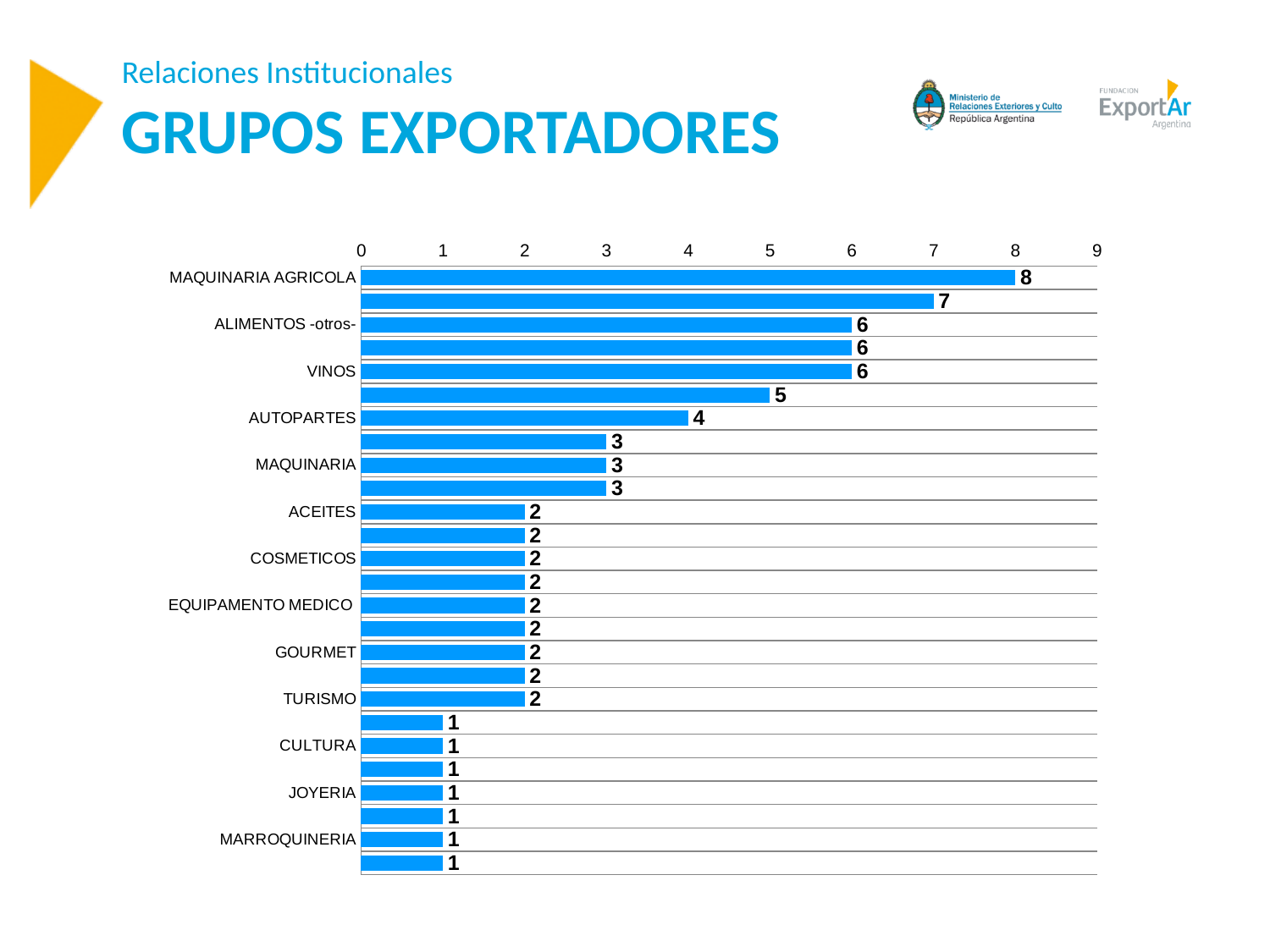
What is the title of the chart on the slide? GRUPOS EXPORTADORES Which labeled category has the highest value? MAQUINARIA AGRICOLA What is the difference between the values for MAQUINARIA AGRICOLA and AUTOPARTES? 4 Which is larger, the value for ALIMENTOS -otros- or the value for MAQUINARIA? ALIMENTOS -otros- What is the value for MAQUINARIA? 3 What is the value for MAQUINARIA AGRICOLA? 8 What is the value for AUTOPARTES? 4 Is the value for MAQUINARIA AGRICOLA greater or less than 5? greater What is the value for JOYERIA? 1 What is the value for TURISMO? 2 What is the value for VINOS? 6 What type of chart is shown on the slide? bar chart